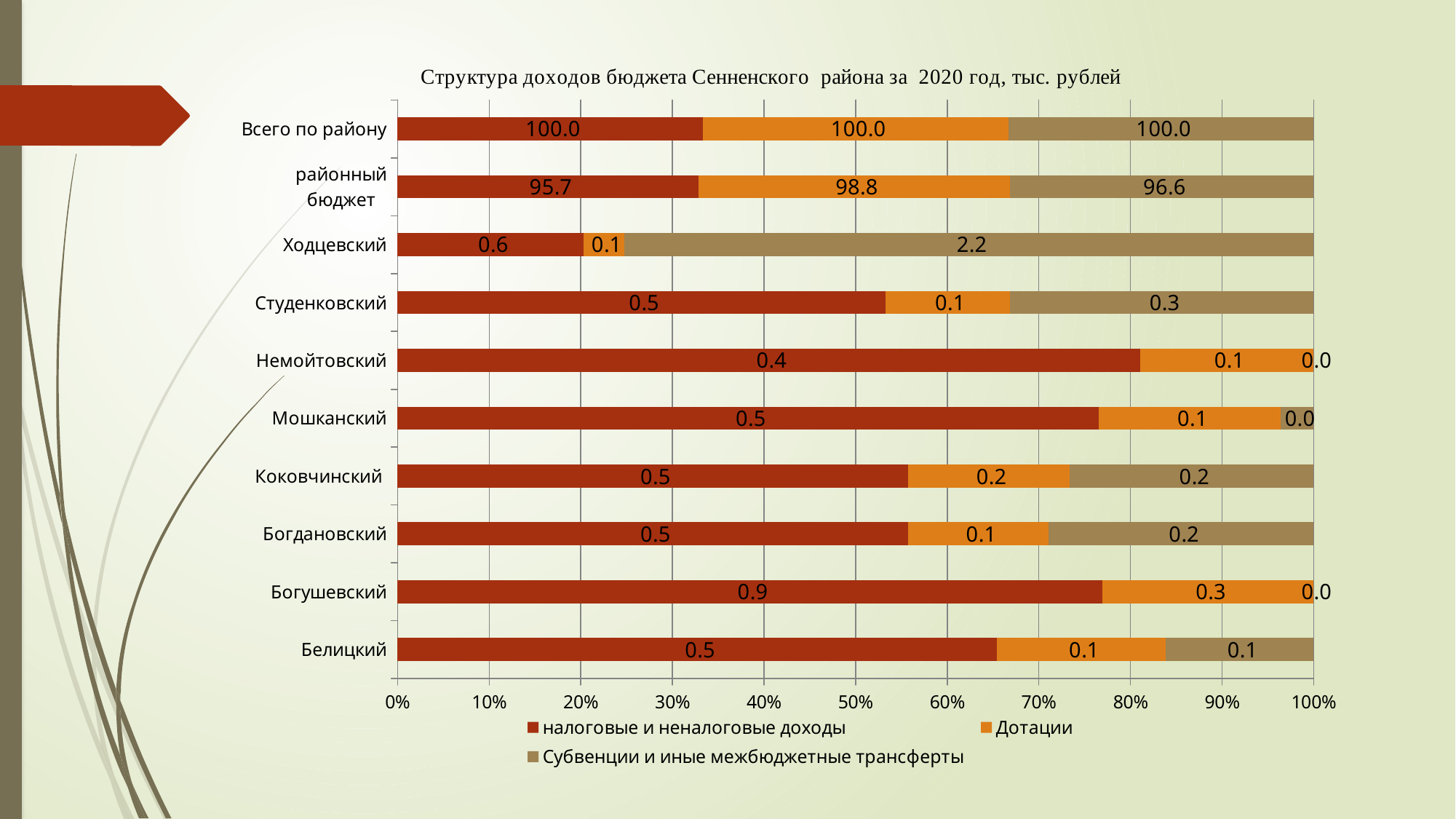
How many categories are shown on the vertical axis? 10 What is the value of Субвенции и иные межбюджетные трансферты for Ходцевский? 2.2 What kind of chart is shown on the slide? Stacked bar chart What is the difference between the Дотации value and the налоговые и неналоговые доходы value for районный бюджет? 3.1 Among the rural councils (excluding Всего по району and районный бюджет), which category has the highest value for Субвенции и иные межбюджетные трансферты? Ходцевский What is the value of Дотации for Коковчинский? 0.2 What is the value of налоговые и неналоговые доходы for Богушевский? 0.9 What is the value of Дотации for районный бюджет? 98.8 How many series does the legend list? 3 What is the title of the chart? Структура доходов бюджета Сенненского района за 2020 год, тыс. рублей Which is larger: the налоговые и неналоговые доходы value for Богушевский or for Белицкий? Богушевский